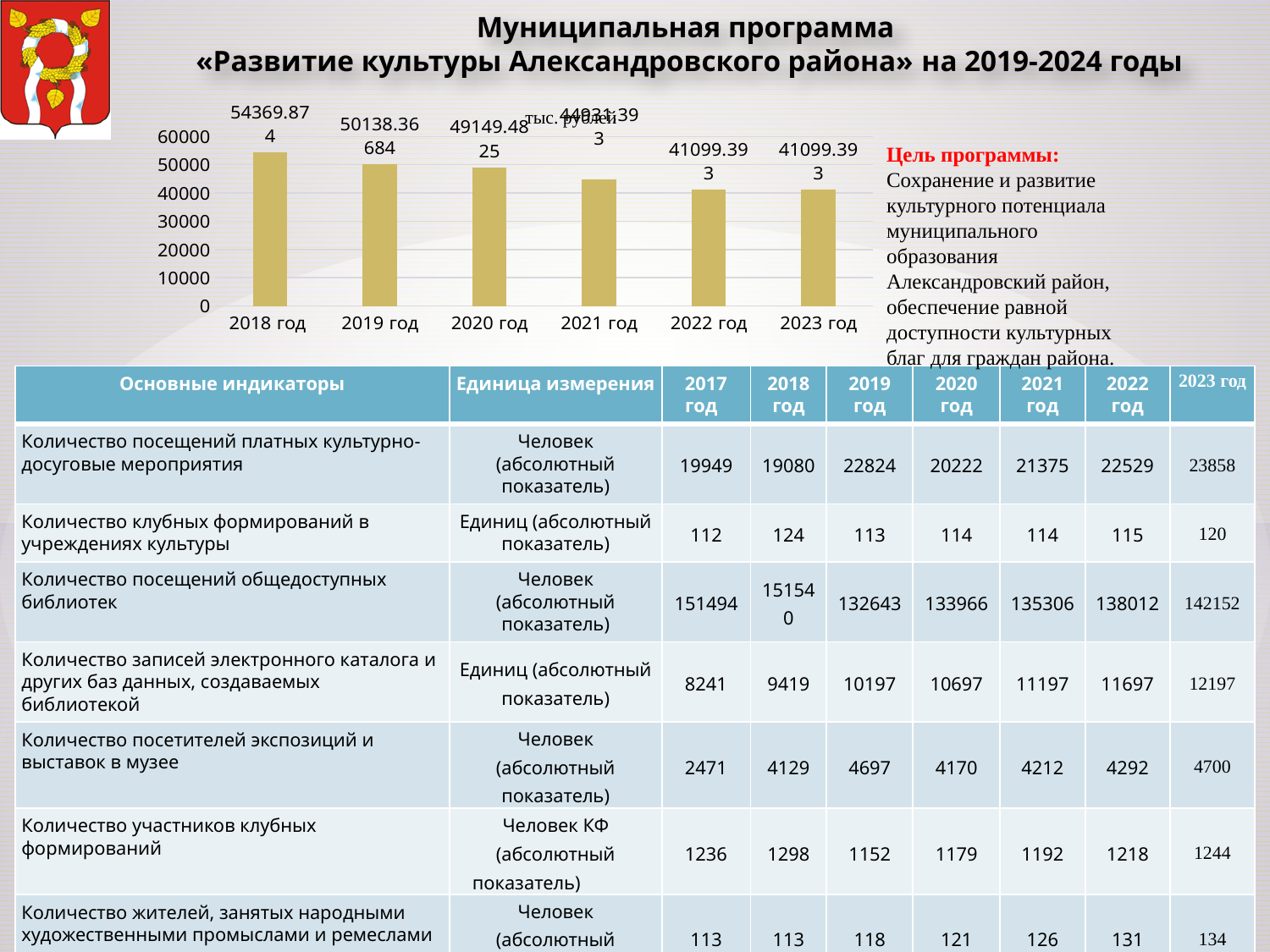
What is the value for 2019 год in the chart? 50138.36684 Is the value for 2021 год greater or less than 40000? greater What type of chart is shown on the slide? bar chart Which is larger, the value for 2018 год or the value for 2023 год? 2018 год What colour are the bars in the chart? yellow (gold) Is the value for 2018 год greater or less than 50000? greater What is the value for 2018 год in the chart? 54369.874 Which year has the highest value in the chart? 2018 год What is the value for 2022 год in the chart? 41099.393 How many years (categories) are plotted in the chart? 6 Do the values in the chart generally rise or fall from 2018 to 2023? fall What is the difference between the values for 2018 год and 2023 год? 13270.481